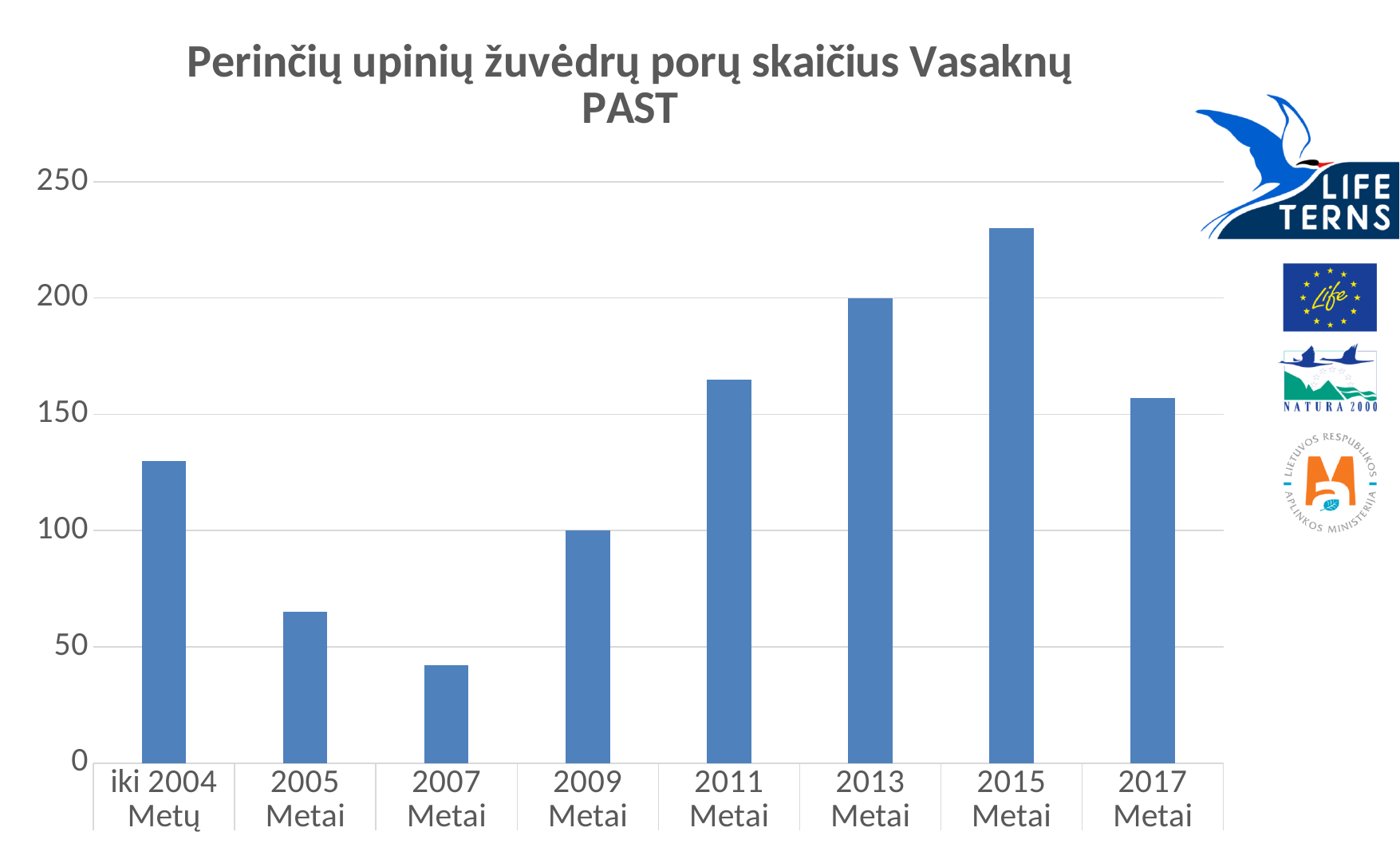
Is the value for 2007 Metai greater or less than 50? less What kind of chart is shown on the slide? bar chart What is the value for 2009 Metai? 100 Which is larger, the value for iki 2004 Metų or the value for 2005 Metai? iki 2004 Metų What is the value for 2013 Metai? 200 Is the value for 2015 Metai greater or less than 200? greater Which category has the lowest value? 2007 Metai Is the value for 2011 Metai greater or less than 150? greater Which category has the highest value? 2015 Metai Do the values rise or fall from 2007 Metai to 2015 Metai? rise How many categories (year groups) are shown on the x axis? 8